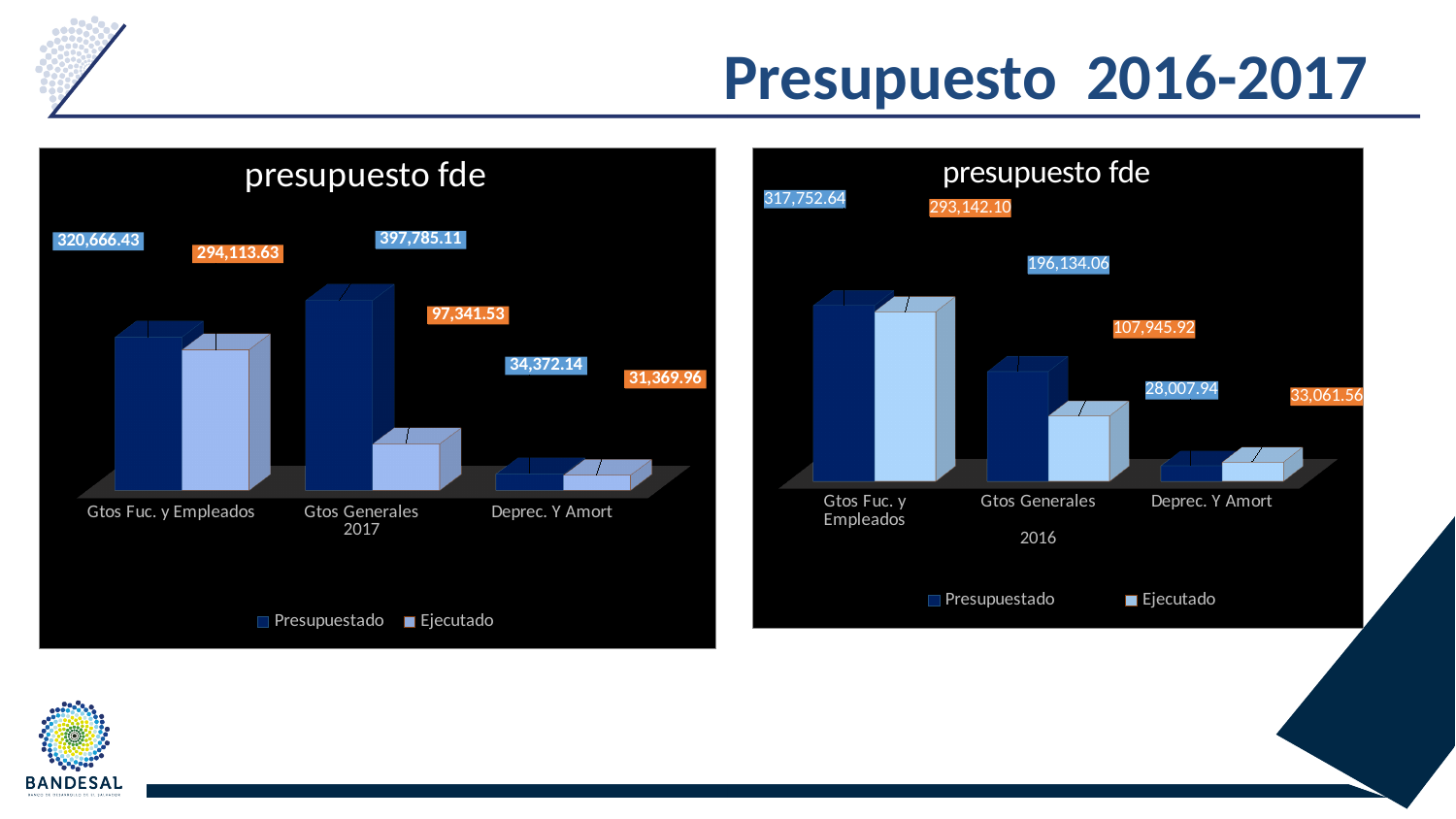
In the left chart (2017), what is the Presupuestado value for Gtos Generales? 397,785.11 In the left chart (2017), what is the Ejecutado value for Gtos Fuc. y Empleados? 294,113.63 In the right chart (2016), what is the Ejecutado value for Deprec. Y Amort? 33,061.56 In the right chart (2016), what is the Presupuestado value for Gtos Fuc. y Empleados? 317,752.64 How many categories are shown on the x axis of the left chart (2017)? 3 What type of chart is the left chart (2017)? Bar chart In the left chart (2017), which category has the highest Presupuestado value? Gtos Generales In the left chart (2017), what is the difference between the Presupuestado and Ejecutado values for Gtos Generales? 300,443.58 How many series does the legend of the right chart (2016) list? 2 In the right chart (2016), what is the difference between the Ejecutado and Presupuestado values for Deprec. Y Amort? 5,053.62 In the right chart (2016), which category has the lowest Ejecutado value? Deprec. Y Amort In the right chart (2016), for Deprec. Y Amort, which is larger: Presupuestado or Ejecutado? Ejecutado